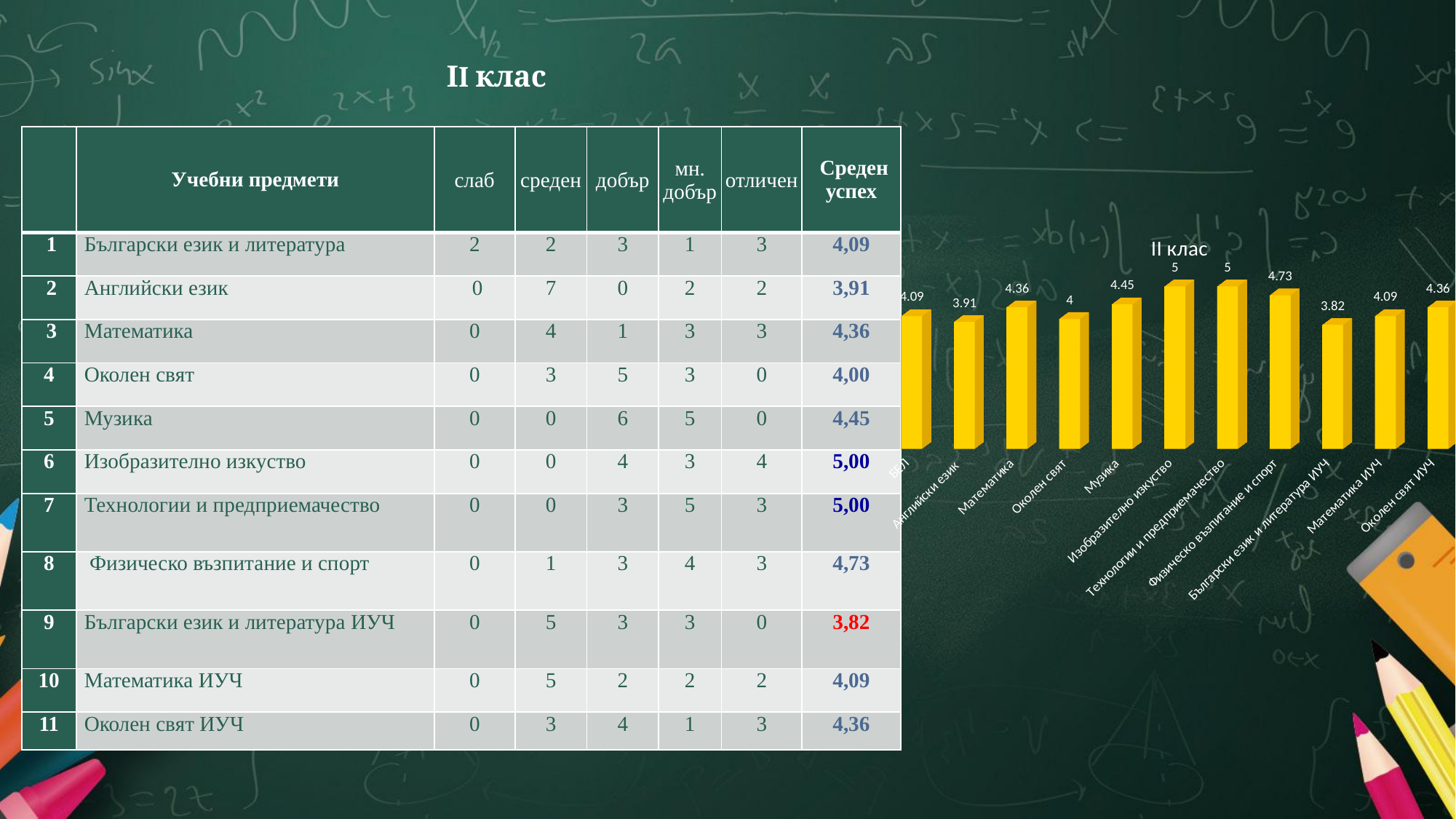
What is the title of the chart? II клас What kind of chart is shown on the slide? bar chart What is the difference between the values for Изобразително изкуство and Математика ИУЧ? 0.91 What is the value for Околен свят in the chart? 4 What is the highest value shown in the chart? 5 How many bars are plotted in the chart? 11 Which is larger in the chart, the value for Математика or the value for Музика? Музика Which category has the lowest value in the chart? Български език и литература ИУЧ What is the difference between the values for Физическо възпитание и спорт and Английски език? 0.82 What is the value for Музика in the chart? 4.45 What is the value for Физическо възпитание и спорт in the chart? 4.73 What is the value for Английски език in the chart? 3.91